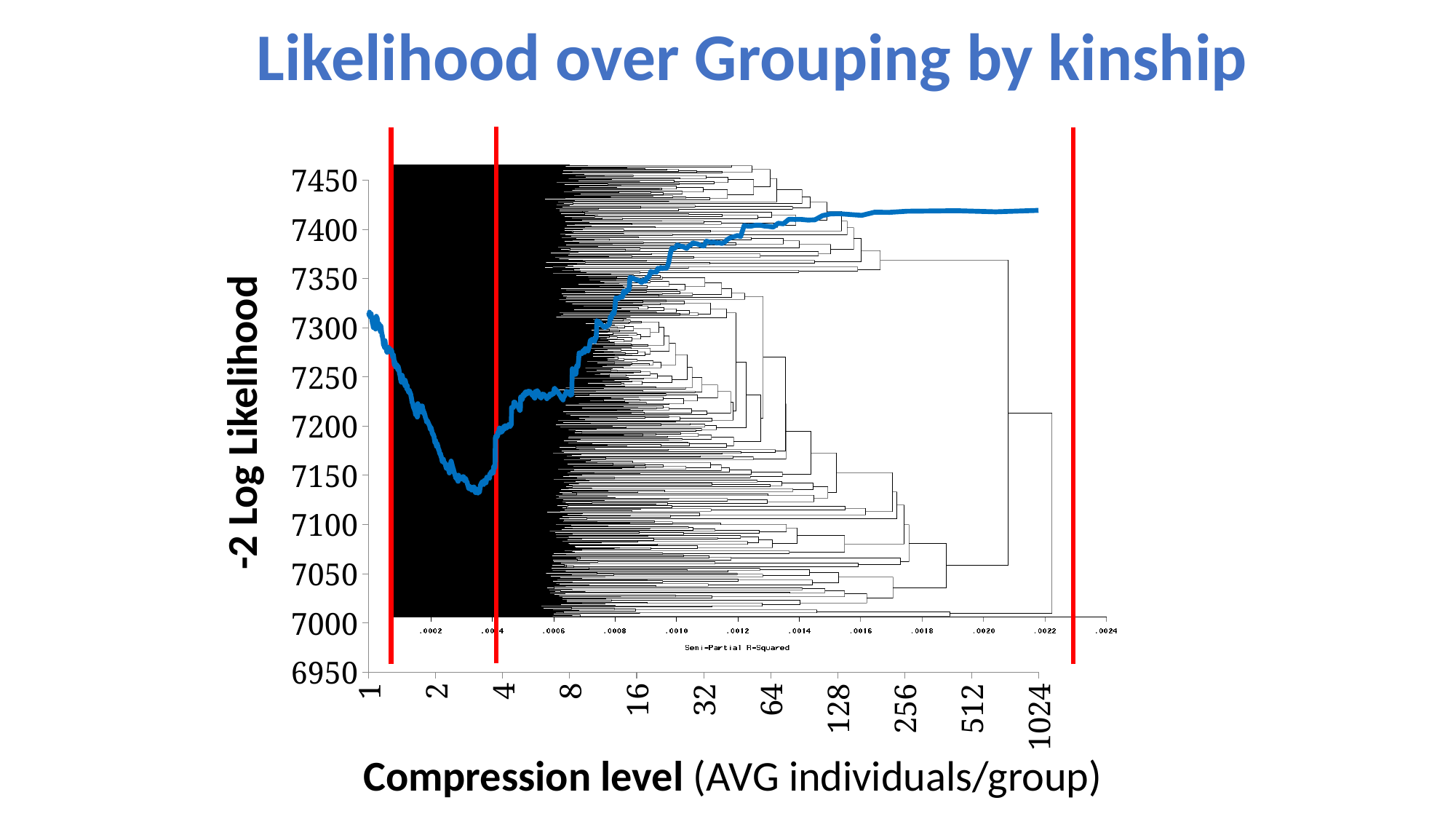
Does the blue line rise or fall as the compression level increases from 8 to 1024? rise Is the value of the blue line at compression level 8 greater or less than 7200? greater Which is larger, the value of the blue line at compression level 1 or at compression level 1024? 1024 How many tick labels are shown on the x axis (Compression level)? 11 What kind of chart is shown on the slide? line chart Which is larger, the value of the blue line at compression level 4 or at compression level 16? 16 What is the title of the chart? Likelihood over Grouping by kinship Is the value of the blue line at compression level 32 greater or less than 7350? greater Is the lowest point of the blue line greater or less than 7150? less Between which two x-axis tick labels does the blue line reach its lowest value? 2 and 4 What is the label of the y axis? -2 Log Likelihood